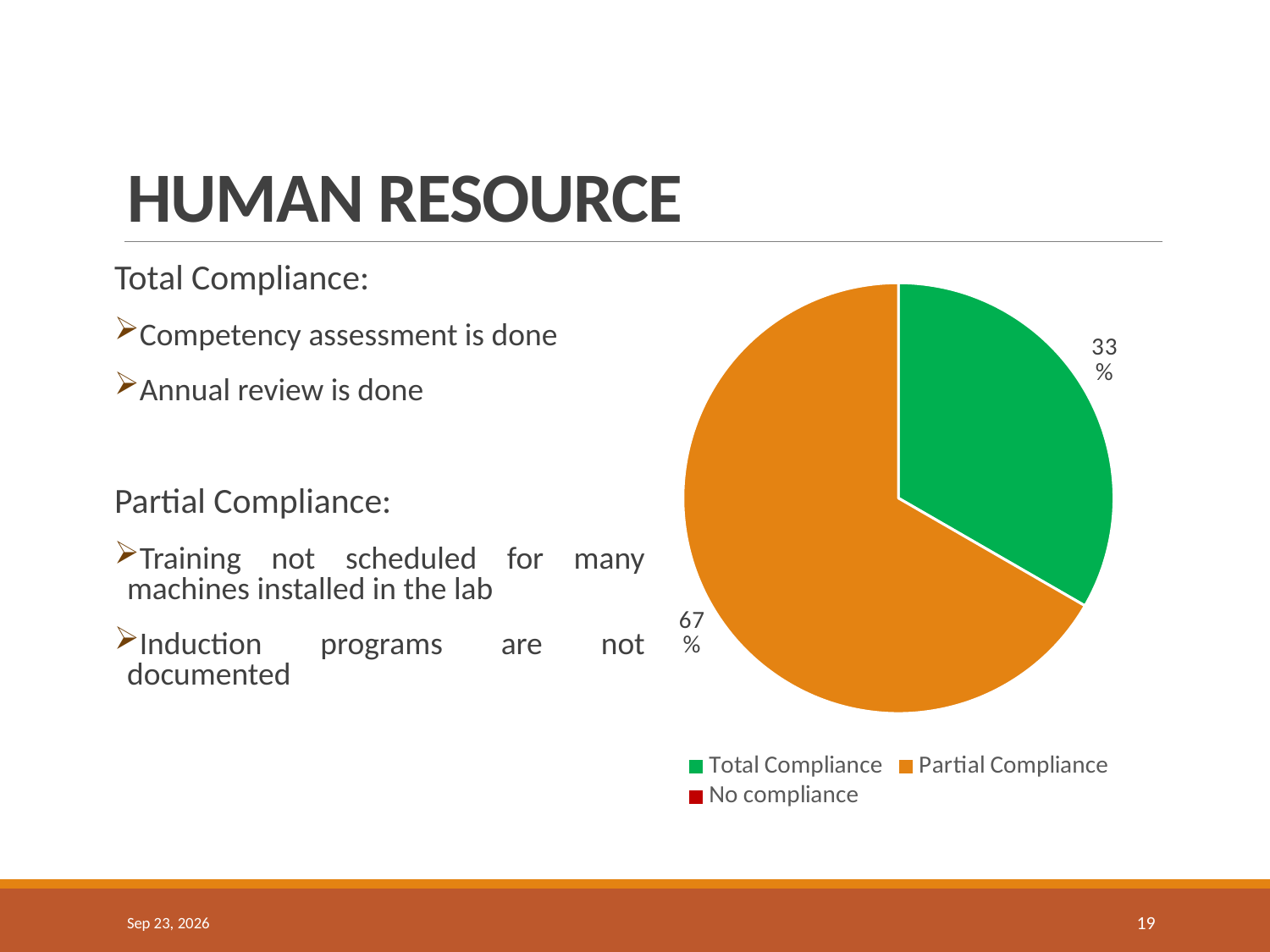
What colour is the Partial Compliance slice? orange Which is larger, the Total Compliance slice or the Partial Compliance slice? Partial Compliance Which category has the largest share of the pie? Partial Compliance Which legend category has no visible slice in the pie? No compliance Which of the two visible slices is smaller, Total Compliance or Partial Compliance? Total Compliance What percentage of the pie is Total Compliance? 33% What percentage of the pie is Partial Compliance? 67% What kind of chart is shown on the slide? pie chart How many slices are visible in the pie? 2 What is the difference in percentage points between the Partial Compliance and Total Compliance slices? 34 How many categories does the legend list? 3